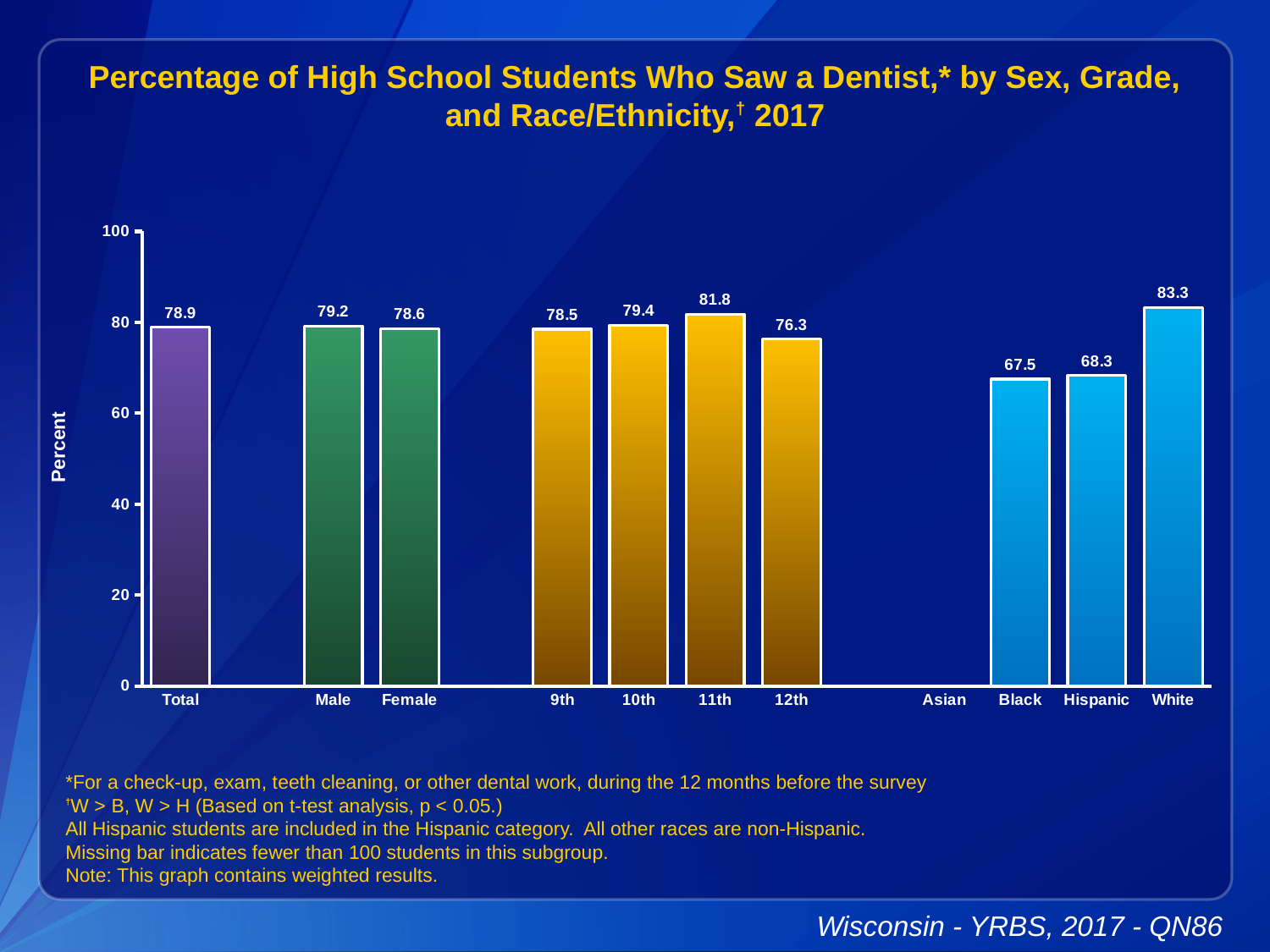
How many categories are labelled on the x axis? 11 What is the difference between the values for White and Black? 15.8 What is the value for Total? 78.9 What is the value for Hispanic? 68.3 What kind of chart is this? bar chart Which is larger, the value for Male or the value for Female? Male Which category has the highest value? White What is the value for 11th grade? 81.8 What is the value for Female? 78.6 Which category with a plotted bar has the lowest value? Black Which category has no bar plotted? Asian Is the value for 12th grade greater or less than 80? less